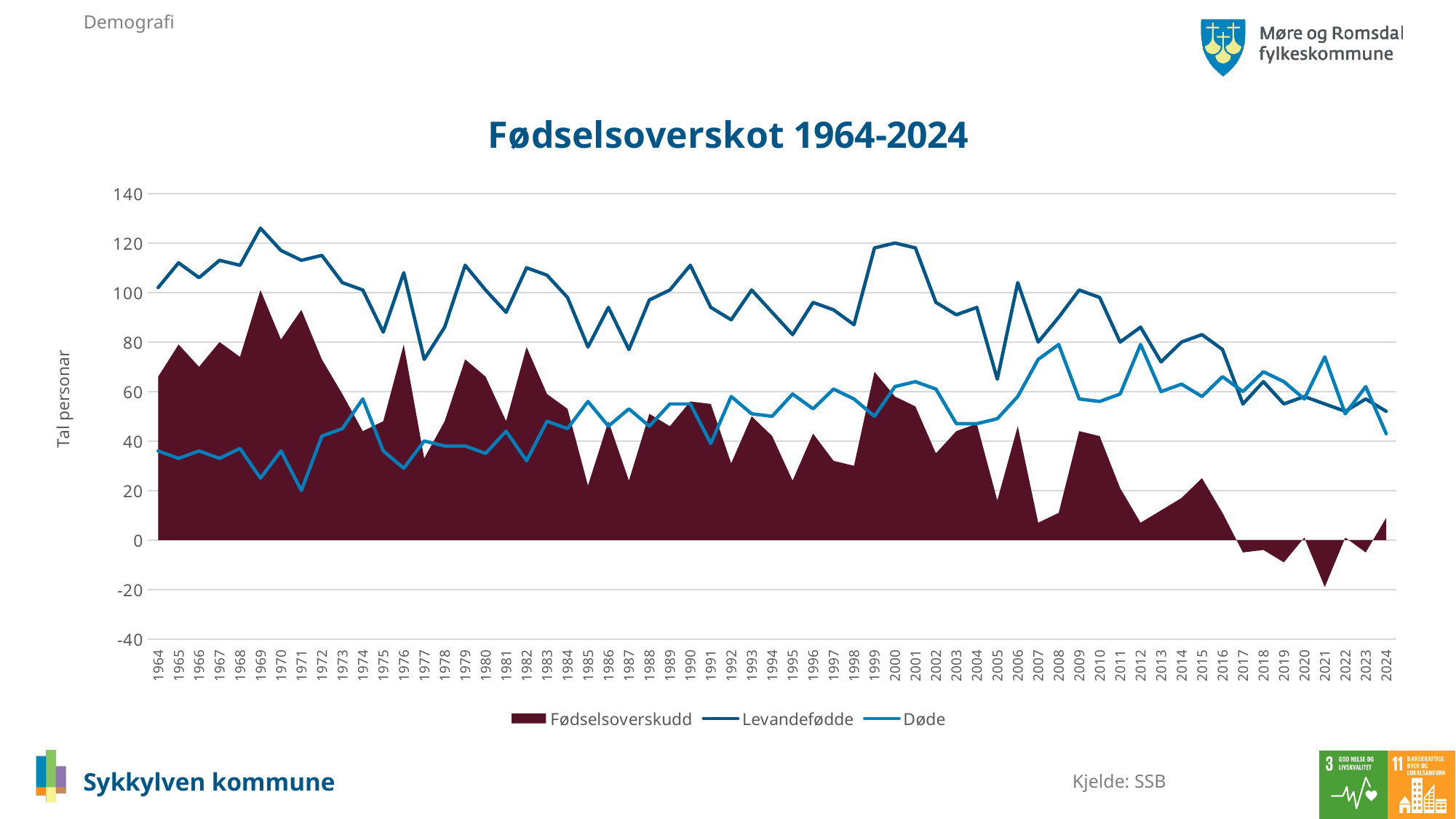
What is the label on the vertical axis? Tal personar Is the value for Levandefødde in 2005 greater or less than 80? less Does the Levandefødde series generally rise or fall from 1964 to 2024? fall In which year is the Fødselsoverskudd series at its lowest? 2021 Is the value for Levandefødde in 1969 greater or less than 120? greater In which year is the Levandefødde series at its highest? 1969 Is the value for Fødselsoverskudd in 2021 greater or less than 0? less What is the title of the chart? Fødselsoverskot 1964-2024 How many years are shown along the x axis? 61 Which is larger in 2021, Levandefødde or Døde? Døde How many series does the legend list? 3